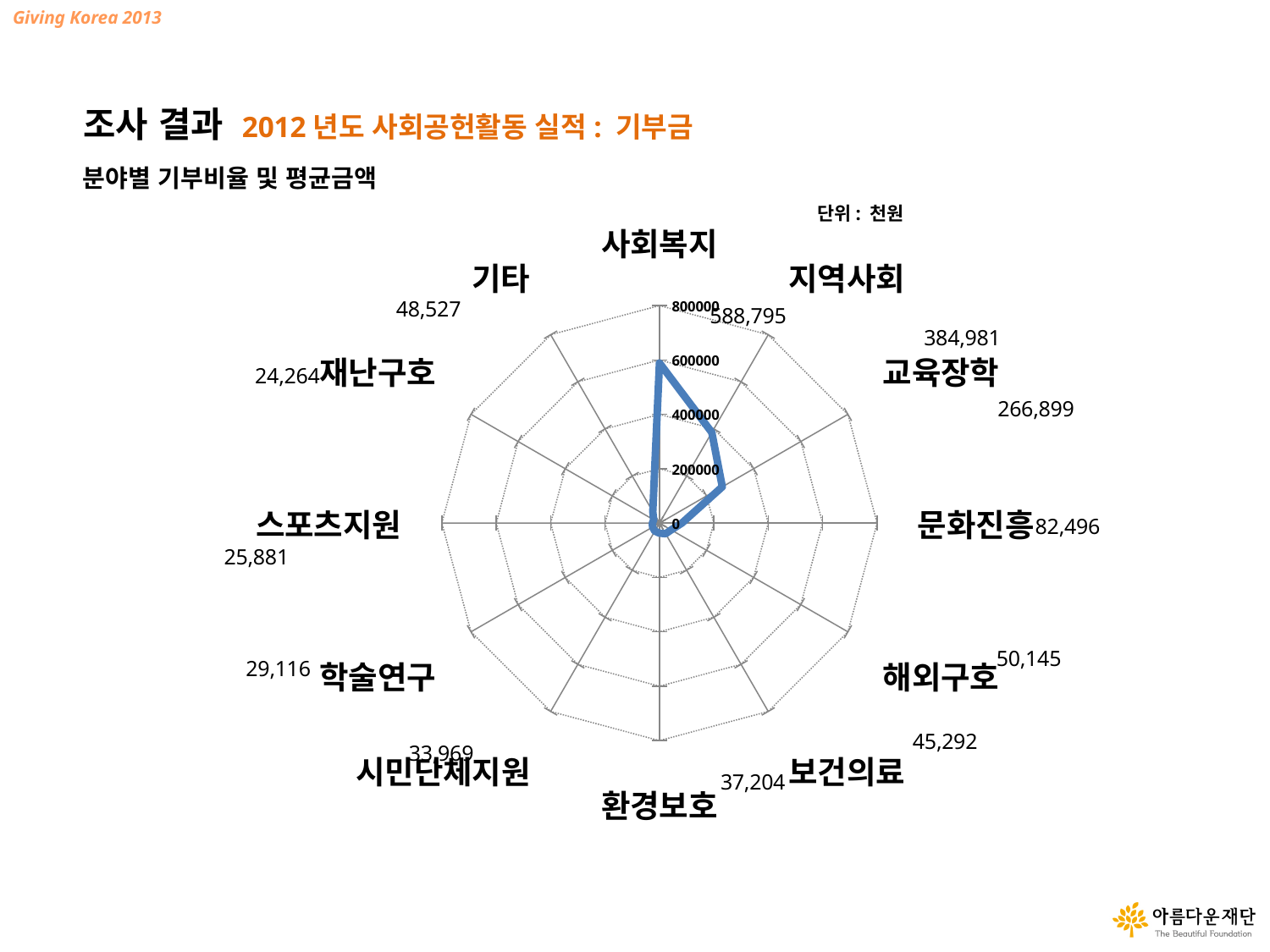
What unit is stated for the values in the chart? 천원 What kind of chart is shown on the slide? radar chart Which category has the lowest value? 재난구호 Is the value for 교육장학 greater or less than 200000? greater Which is larger, the value for 해외구호 or the value for 보건의료? 해외구호 What is the value for 기타? 48,527 What is the value for 문화진흥? 82,496 What is the value for 지역사회? 384,981 What is the value for 교육장학? 266,899 Which category has the highest value? 사회복지 What is the value for 사회복지? 588,795 What is the difference between the values for 사회복지 and 지역사회? 203,814